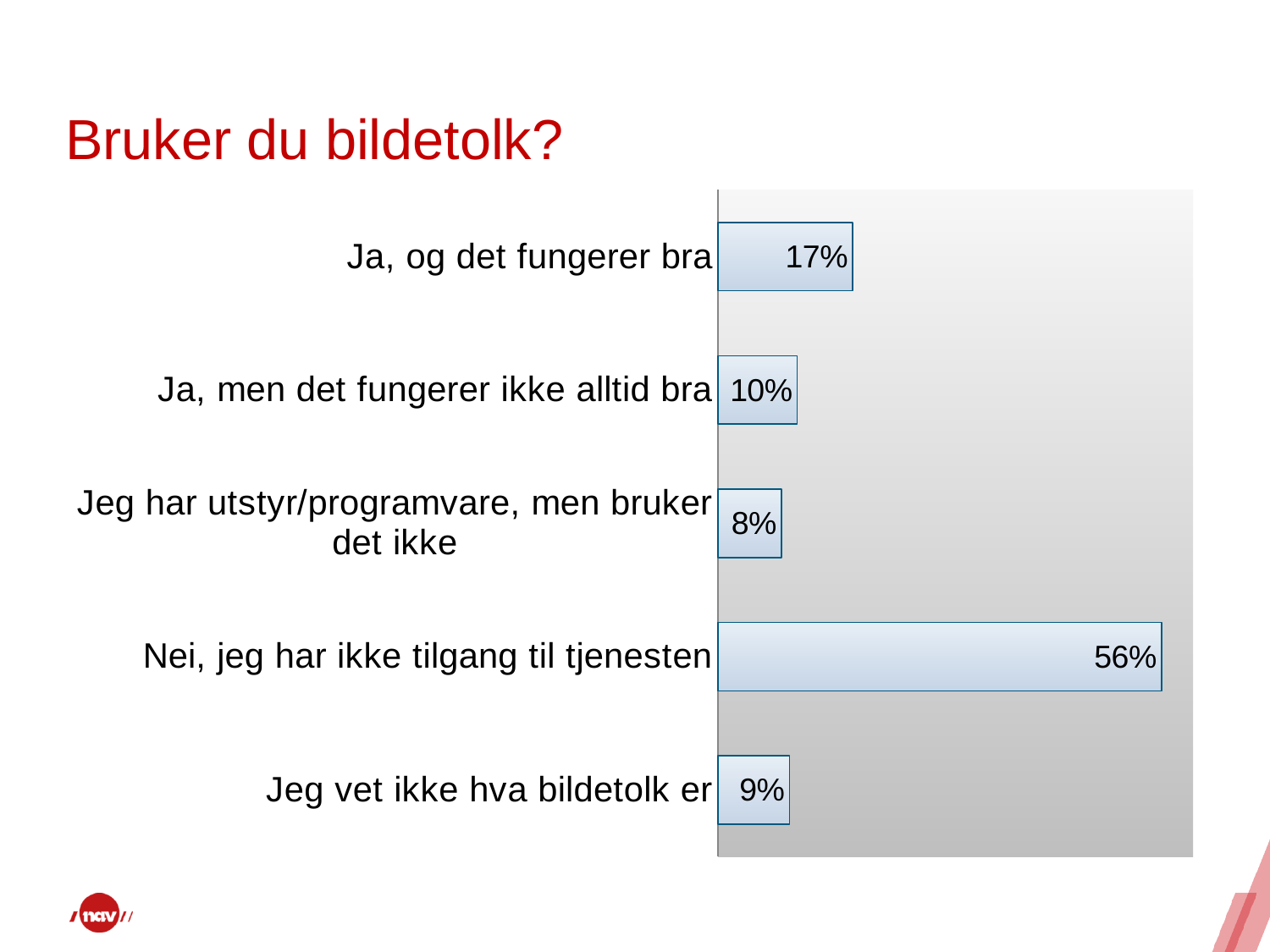
What is the value for "Jeg vet ikke hva bildetolk er"? 9% What is the title of the slide? Bruker du bildetolk? How many response categories are shown in the chart? 5 Which response category has the highest value? Nei, jeg har ikke tilgang til tjenesten What percentage of respondents answered "Ja, og det fungerer bra"? 17% What kind of chart is shown on the slide? Bar chart What is the value for "Nei, jeg har ikke tilgang til tjenesten"? 56% Which response category has the lowest value? Jeg har utstyr/programvare, men bruker det ikke What is the value for "Jeg har utstyr/programvare, men bruker det ikke"? 8% Which is larger: "Ja, men det fungerer ikke alltid bra" or "Jeg vet ikke hva bildetolk er"? Ja, men det fungerer ikke alltid bra What is the difference between "Ja, og det fungerer bra" and "Ja, men det fungerer ikke alltid bra"? 7% What is the difference between "Nei, jeg har ikke tilgang til tjenesten" and "Ja, og det fungerer bra"? 39%